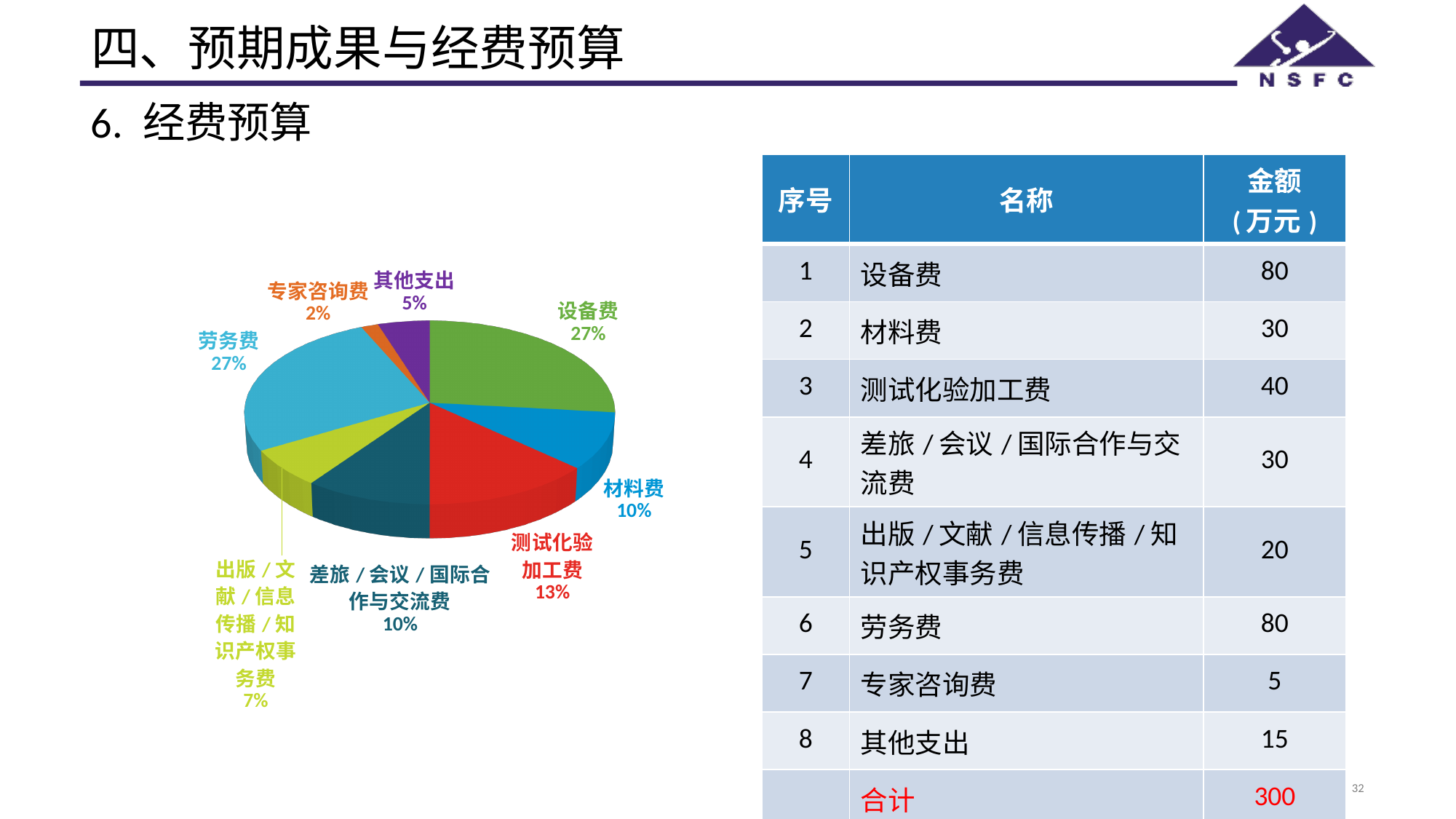
What percentage is shown for 出版／文献／信息传播／知识产权事务费 in the pie chart? 7% What colour is the 劳务费 slice in the pie chart? light blue Which is larger in the pie chart, 测试化验加工费 or 材料费? 测试化验加工费 Which slice of the pie chart is the smallest? 专家咨询费 How many slices does the pie chart have? 8 What percentage is shown for 其他支出 in the pie chart? 5% What is the difference in percentage points between 劳务费 and 测试化验加工费 in the pie chart? 14 What share of the pie does 设备费 represent? 27% What percentage is shown for 测试化验加工费 in the pie chart? 13% What kind of chart is shown on the slide? pie chart What share of the pie does 材料费 represent? 10% What percentage is shown for 差旅／会议／国际合作与交流费 in the pie chart? 10%